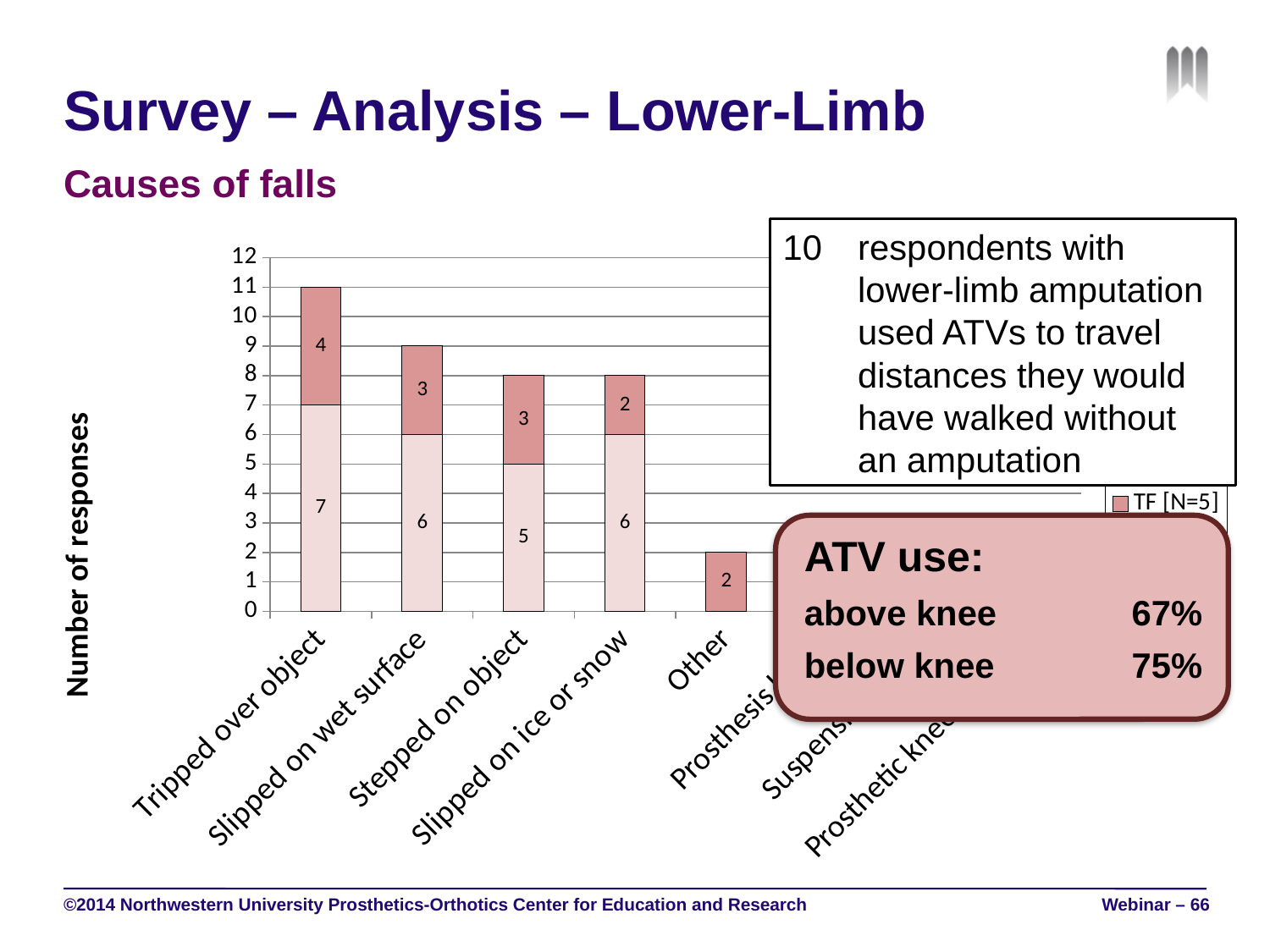
What is the total number of responses for "Slipped on wet surface"? 9 What is the difference between the total responses for "Tripped over object" and "Slipped on wet surface"? 2 What is the difference between the TF [N=5] values for "Tripped over object" and "Other"? 2 What is the TF [N=5] value for "Other"? 2 What is the total number of responses for "Tripped over object"? 11 Which has a larger TF [N=5] value, "Tripped over object" or "Slipped on ice or snow"? Tripped over object What kind of chart is shown on the slide? bar chart Is the total number of responses for "Stepped on object" greater or less than 10? less What is the TF [N=5] value for "Slipped on wet surface"? 3 What is the label of the vertical axis? Number of responses What is the TF [N=5] value for "Tripped over object"? 4 Which cause of falls has the highest total number of responses? Tripped over object